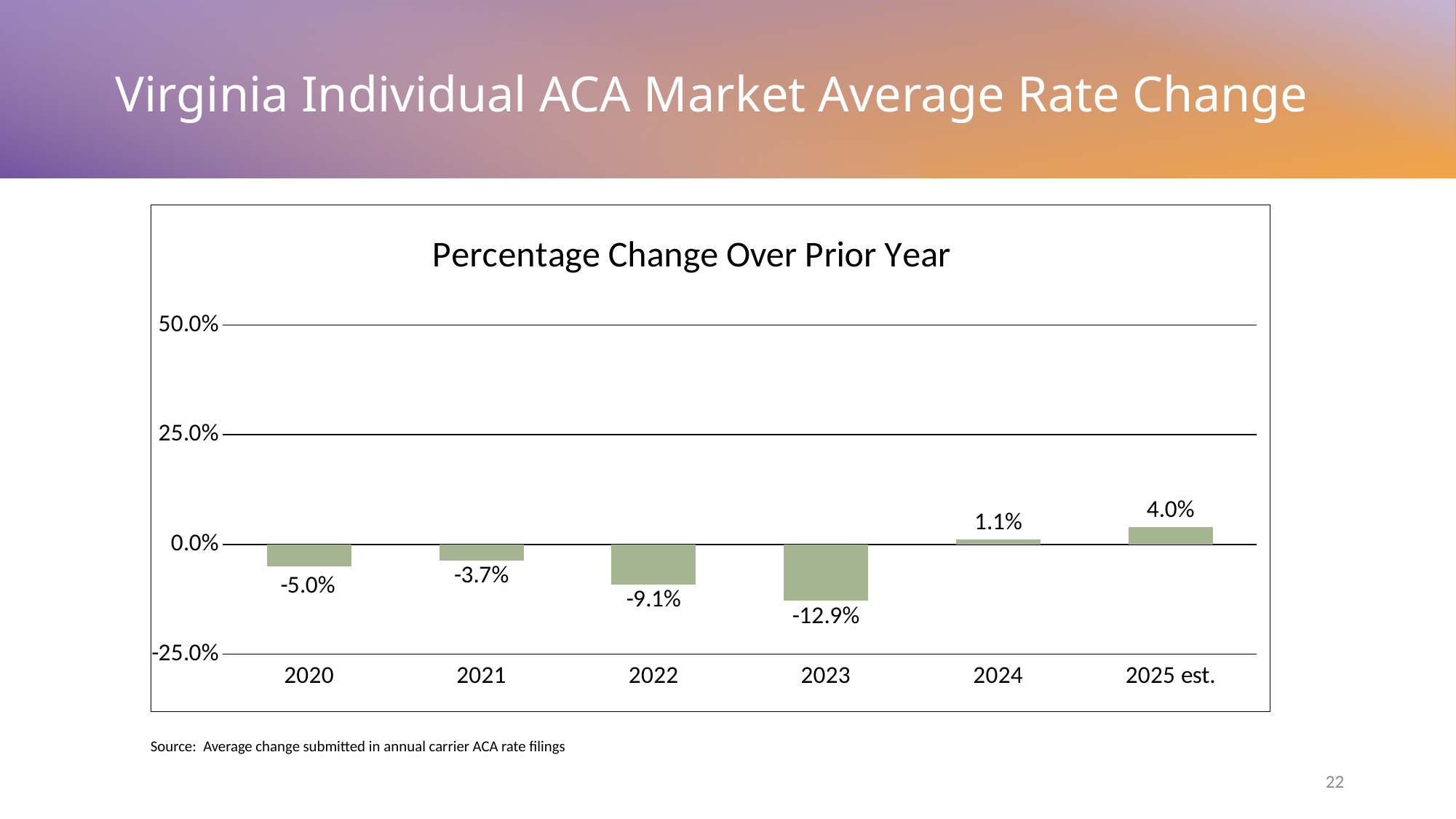
What is the difference between the 2025 est. value and the 2024 value? 2.9% Which is larger, the value for 2020 or the value for 2021? 2021 What is the percentage change for 2020? -5.0% What kind of chart is shown? bar chart What is the percentage change for 2023? -12.9% How many years are shown on the x axis? 6 Which year has the lowest percentage change? 2023 Is the value for 2023 greater or less than 0.0%? less Which year has the highest percentage change? 2025 est. What is the title of the chart? Percentage Change Over Prior Year What is the percentage change for 2025 est.? 4.0% What is the difference between the 2022 value and the 2021 value? -5.4%